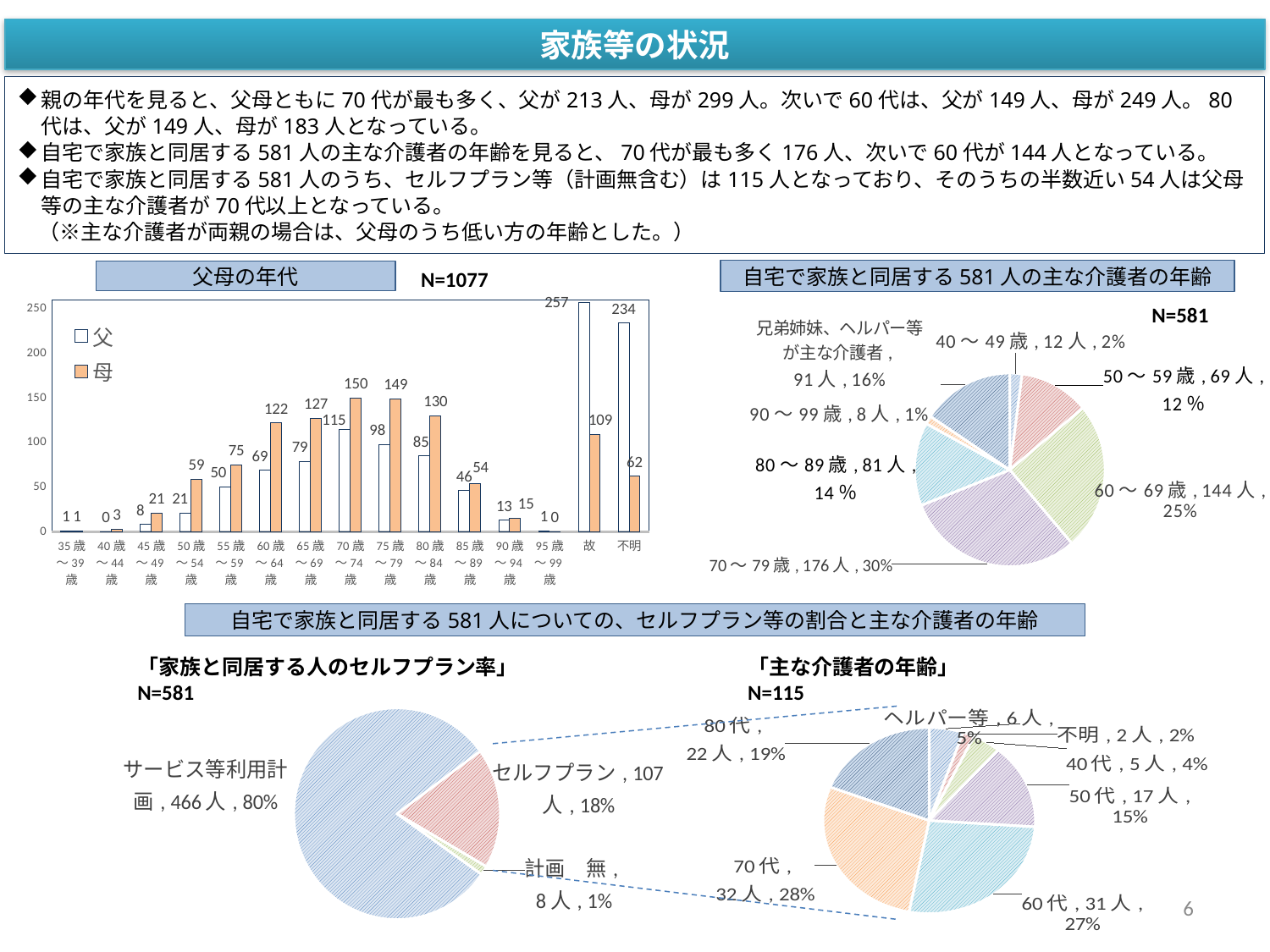
「父母の年代」のグラフで、父の値が最も大きいカテゴリはどれですか？ 故 「父母の年代」のグラフはどの種類のグラフですか？ 棒グラフ 「家族と同居する人のセルフプラン率」の円グラフで、セルフプランの人数はいくつですか？ 107人 「父母の年代」のグラフで、75歳～79歳の母と父の人数の差はいくつですか？ 51 「主な介護者の年齢」（N=115）の円グラフで、60代と70代ではどちらの人数が多いですか？ 70代 「父母の年代」のグラフで、60歳～64歳の父の人数はいくつですか？ 69 「主な介護者の年齢」（N=115）の円グラフで、50代の割合は何％ですか？ 15% 「自宅で家族と同居する581人の主な介護者の年齢」の円グラフで、60～69歳の人数はいくつですか？ 144人 「自宅で家族と同居する581人の主な介護者の年齢」の円グラフで、最も割合が大きい区分はどれですか？ 70～79歳 「自宅で家族と同居する581人の主な介護者の年齢」の円グラフで、80～89歳の割合は何％ですか？ 14％ 「父母の年代」のグラフで、凡例に示されている系列はいくつありますか？ 2 「父母の年代」のグラフで、70歳～74歳の母の人数はいくつですか？ 150